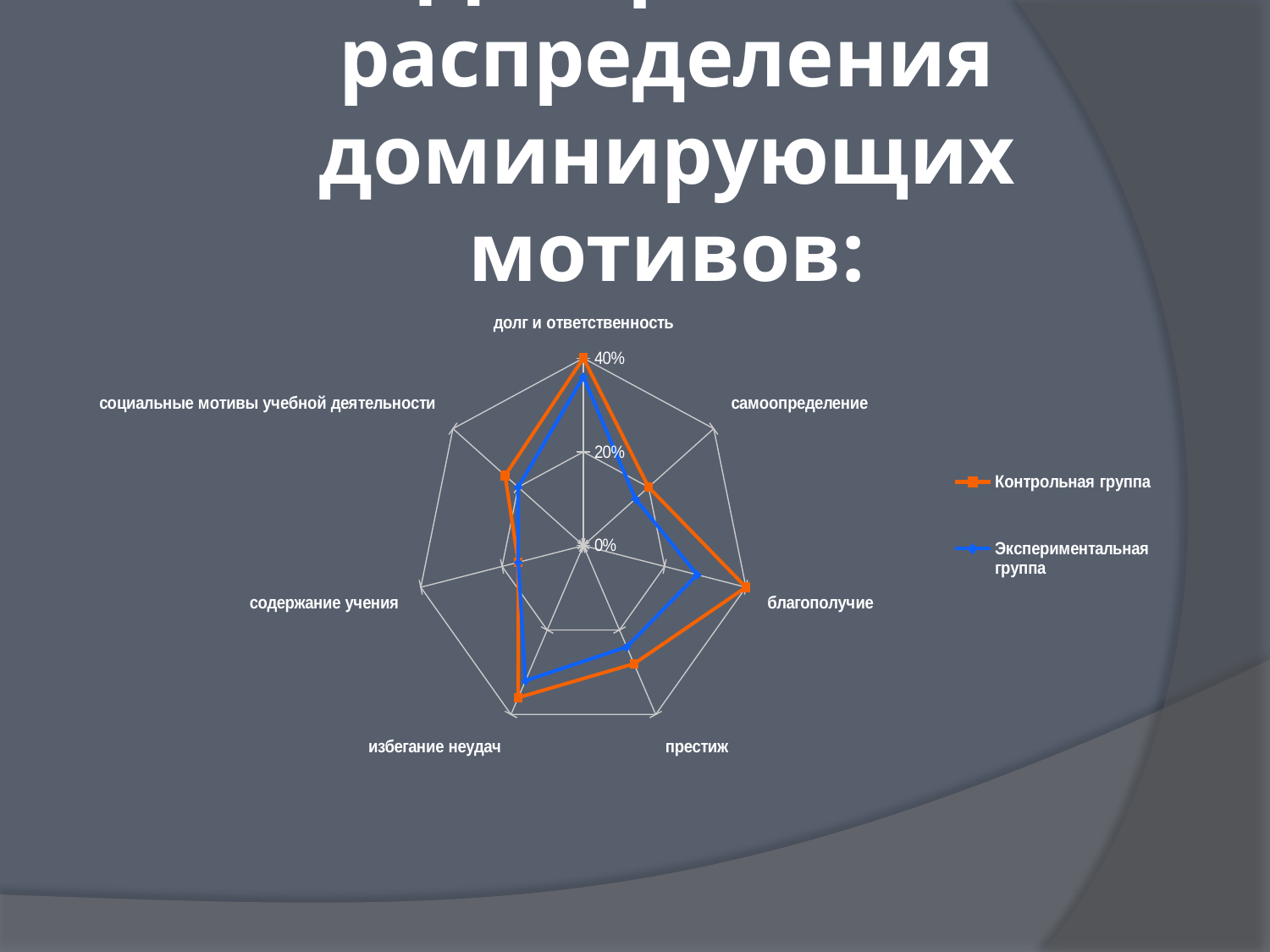
Is the value for содержание учения in the Контрольная группа series greater or less than 20%? less How many series does the legend list? 2 Which colour represents the Контрольная группа series? orange How many categories (axes) does the radar chart have? 7 Is the value for благополучие in the Контрольная группа series greater or less than 20%? greater For благополучие, which group has the higher value? Контрольная группа For самоопределение, which group has the higher value? Контрольная группа Is the value for избегание неудач in the Контрольная группа series greater or less than 20%? greater What kind of chart is shown on the slide? radar chart What is the highest percentage tick shown on the chart's axis? 40% For долг и ответственность, which group has the higher value? Контрольная группа